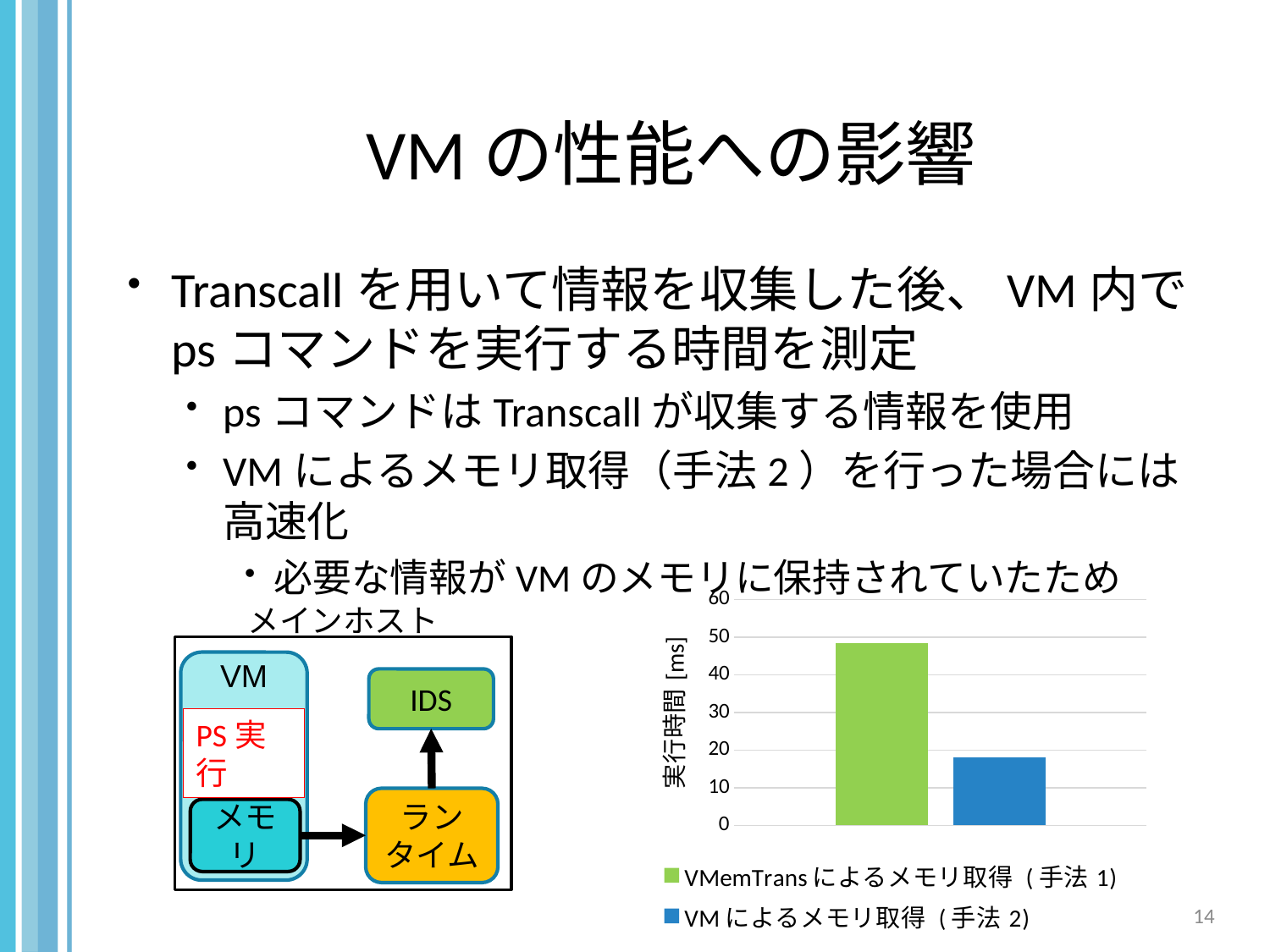
Is the value for VMemTrans によるメモリ取得（手法 1） greater or less than 40? greater What is the label of the vertical axis of the chart? 実行時間 [ms] How many bars are plotted in the chart? 2 What colour is the bar for VM によるメモリ取得（手法 2）? blue Which series has the lowest execution time in the chart? VM によるメモリ取得（手法 2） Which is larger: the execution time for VMemTrans によるメモリ取得（手法 1） or for VM によるメモリ取得（手法 2）? VMemTrans によるメモリ取得（手法 1） What kind of chart is shown on the slide? bar chart Which series has the highest execution time in the chart? VMemTrans によるメモリ取得（手法 1） How many series does the chart legend list? 2 Is the value for VM によるメモリ取得（手法 2） greater or less than 10? greater